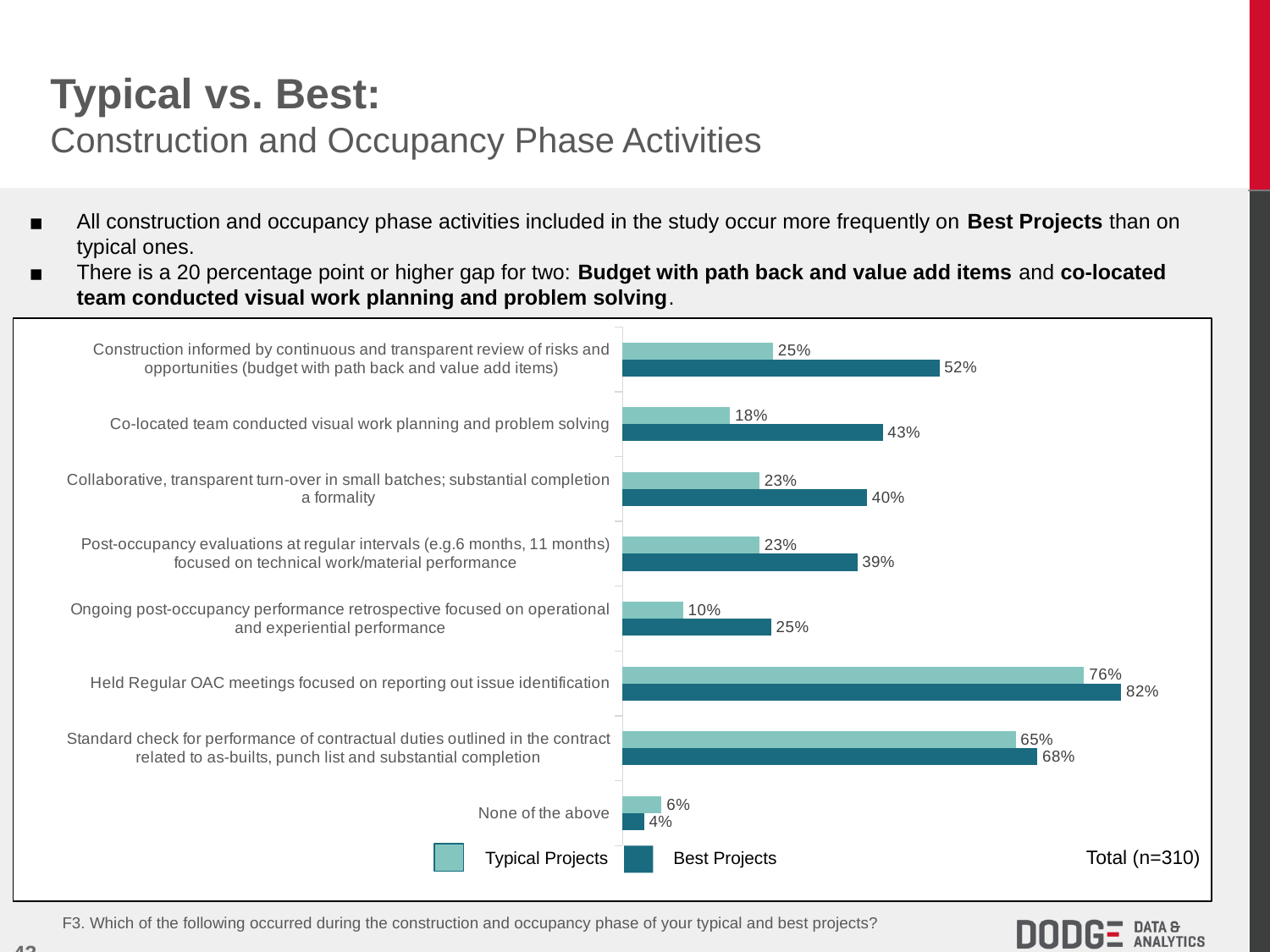
For 'None of the above', which is larger: the Typical Projects value or the Best Projects value? Typical Projects What is the difference between the Best Projects and Typical Projects values for 'Construction informed by continuous and transparent review of risks and opportunities (budget with path back and value add items)'? 27 percentage points How many categories are shown in the chart? 8 How many series does the legend list? 2 What kind of chart is shown on the slide? Bar chart What sample size is noted on the chart? Total (n=310) What is the Typical Projects value for 'Ongoing post-occupancy performance retrospective focused on operational and experiential performance'? 10% Which category has the highest Best Projects value? Held Regular OAC meetings focused on reporting out issue identification What is the Typical Projects value for 'None of the above'? 6% Which category has the lowest Typical Projects value? None of the above What is the difference between the Best Projects and Typical Projects values for 'Standard check for performance of contractual duties outlined in the contract related to as-builts, punch list and substantial completion'? 3 percentage points What is the Best Projects value for 'Co-located team conducted visual work planning and problem solving'? 43%